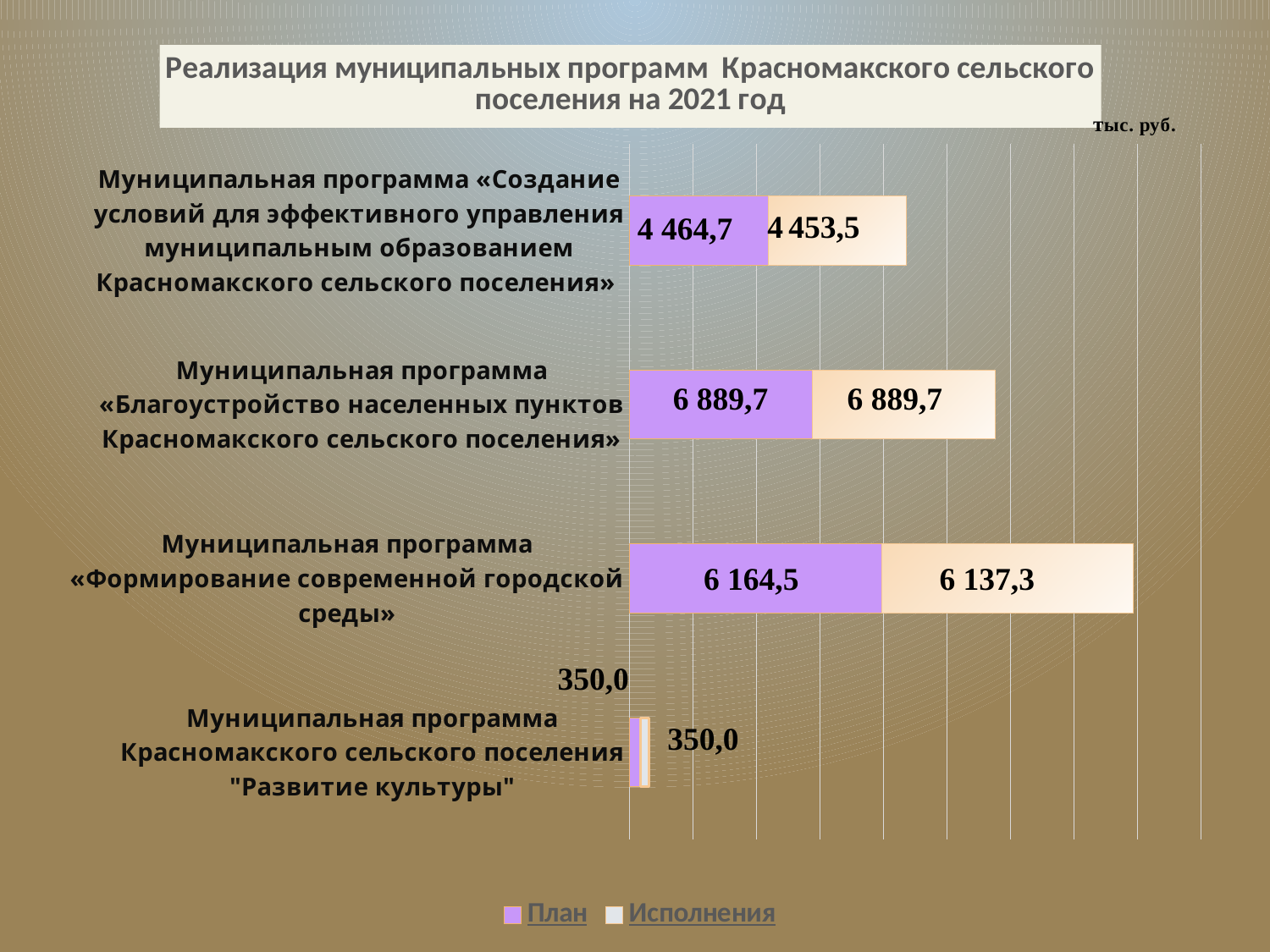
What is the План value for the programme «Формирование современной городской среды»? 6 164,5 What is the total of the stacked bar for the programme "Развитие культуры"? 700,0 What is the Исполнения value for the programme «Благоустройство населенных пунктов Красномакского сельского поселения»? 6 889,7 How many series does the legend list? 2 What is the difference between the План and Исполнения values for the programme «Создание условий для эффективного управления муниципальным образованием Красномакского сельского поселения»? 11,2 What kind of chart is shown on the slide? Stacked bar chart Which programme has the lowest Исполнения value? Муниципальная программа Красномакского сельского поселения "Развитие культуры" What is the difference between the План and Исполнения values for the programme «Формирование современной городской среды»? 27,2 How many programmes (categories) are shown in the chart? 4 What is the Исполнения value for the programme «Создание условий для эффективного управления муниципальным образованием Красномакского сельского поселения»? 4 453,5